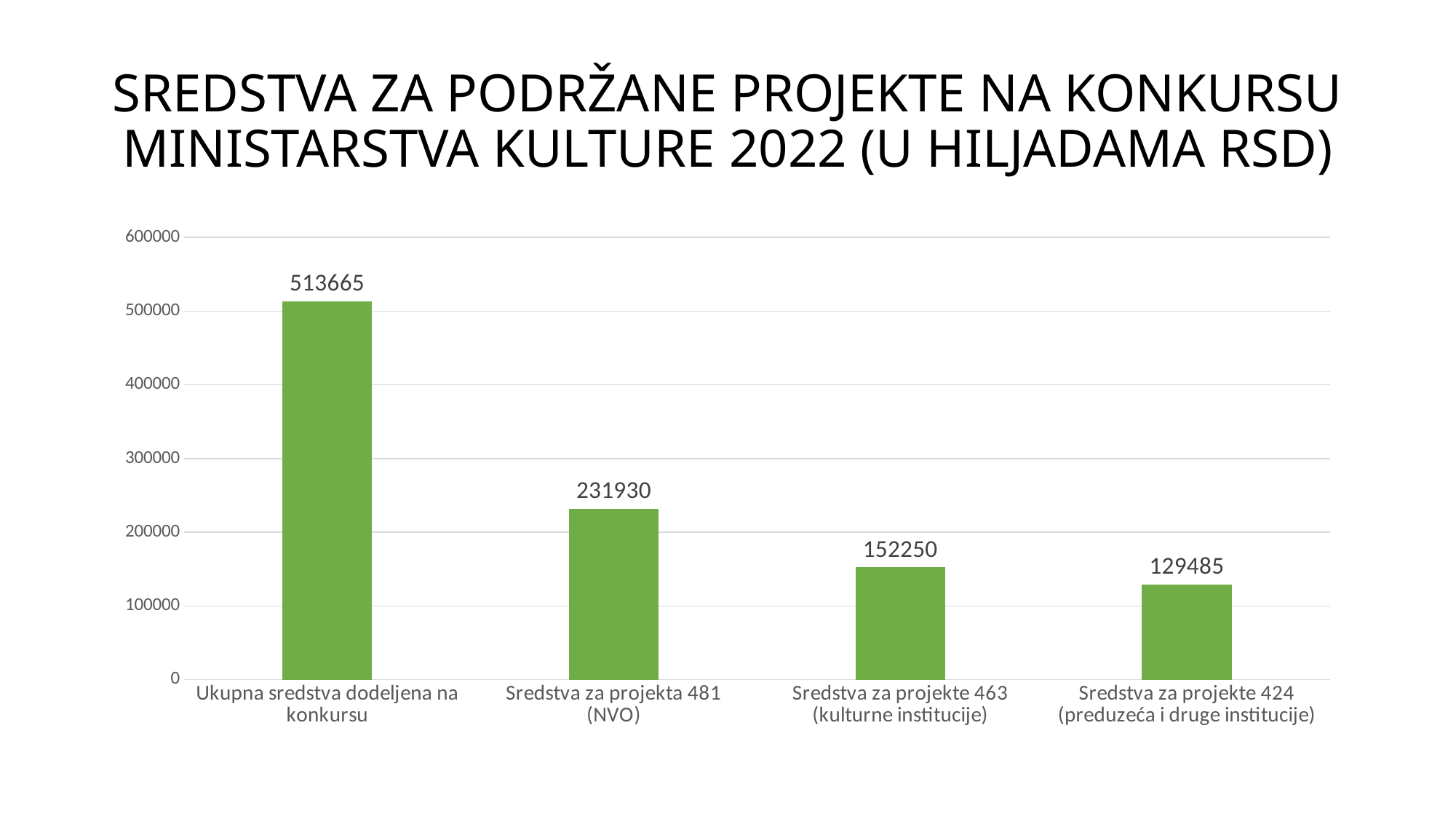
What kind of chart is shown on the slide? bar chart Which category has the highest value? Ukupna sredstva dodeljena na konkursu Which category has the lowest value? Sredstva za projekte 424 (preduzeća i druge institucije) How many categories are shown in the chart? 4 What is the value for "Sredstva za projekte 463 (kulturne institucije)"? 152250 What is the value for "Ukupna sredstva dodeljena na konkursu"? 513665 Is the value for "Sredstva za projekte 424 (preduzeća i druge institucije)" greater or less than 200000? less What is the value for "Sredstva za projekte 424 (preduzeća i druge institucije)"? 129485 What is the difference between the value for "Sredstva za projekte 463 (kulturne institucije)" and the value for "Sredstva za projekte 424 (preduzeća i druge institucije)"? 22765 What is the value for "Sredstva za projekta 481 (NVO)"? 231930 Which is larger: the value for "Sredstva za projekta 481 (NVO)" or the value for "Sredstva za projekte 463 (kulturne institucije)"? Sredstva za projekta 481 (NVO) What is the difference between the value for "Sredstva za projekta 481 (NVO)" and the value for "Sredstva za projekte 463 (kulturne institucije)"? 79680